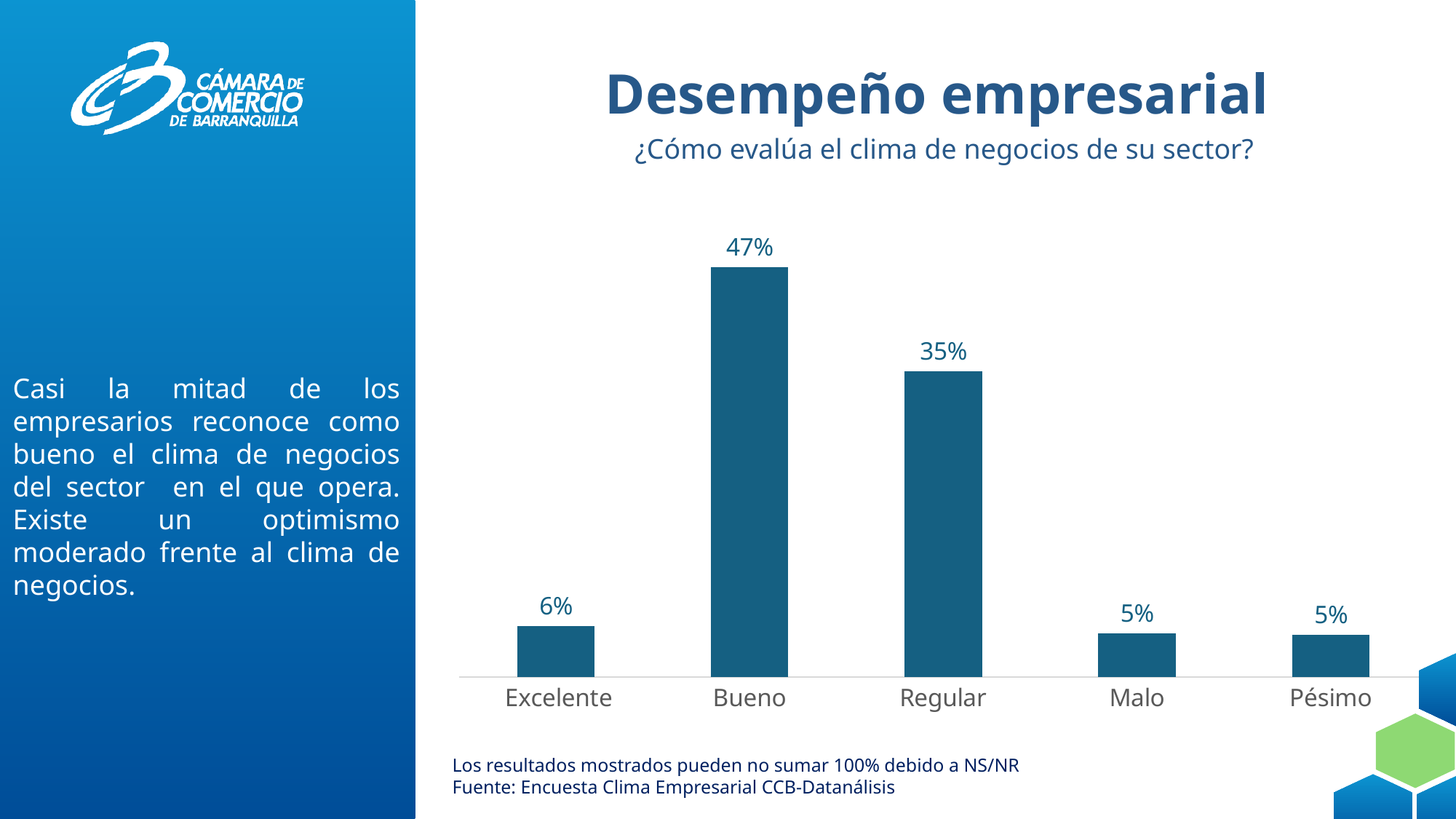
What is the difference between the values for Excelente and Pésimo? 1% What percentage of respondents rated the business climate as Bueno? 47% What question does the chart subtitle say respondents were asked? ¿Cómo evalúa el clima de negocios de su sector? Which is larger, the value for Regular or the value for Excelente? Regular How many categories are shown on the x axis? 5 What is the difference between the values for Bueno and Regular? 12% What is the value shown for Malo? 5% What is the value shown for Regular? 35% What is the combined value of Malo and Pésimo? 10% What kind of chart is shown on the slide? Bar chart What is the value shown for Excelente? 6% Which category has the highest value? Bueno